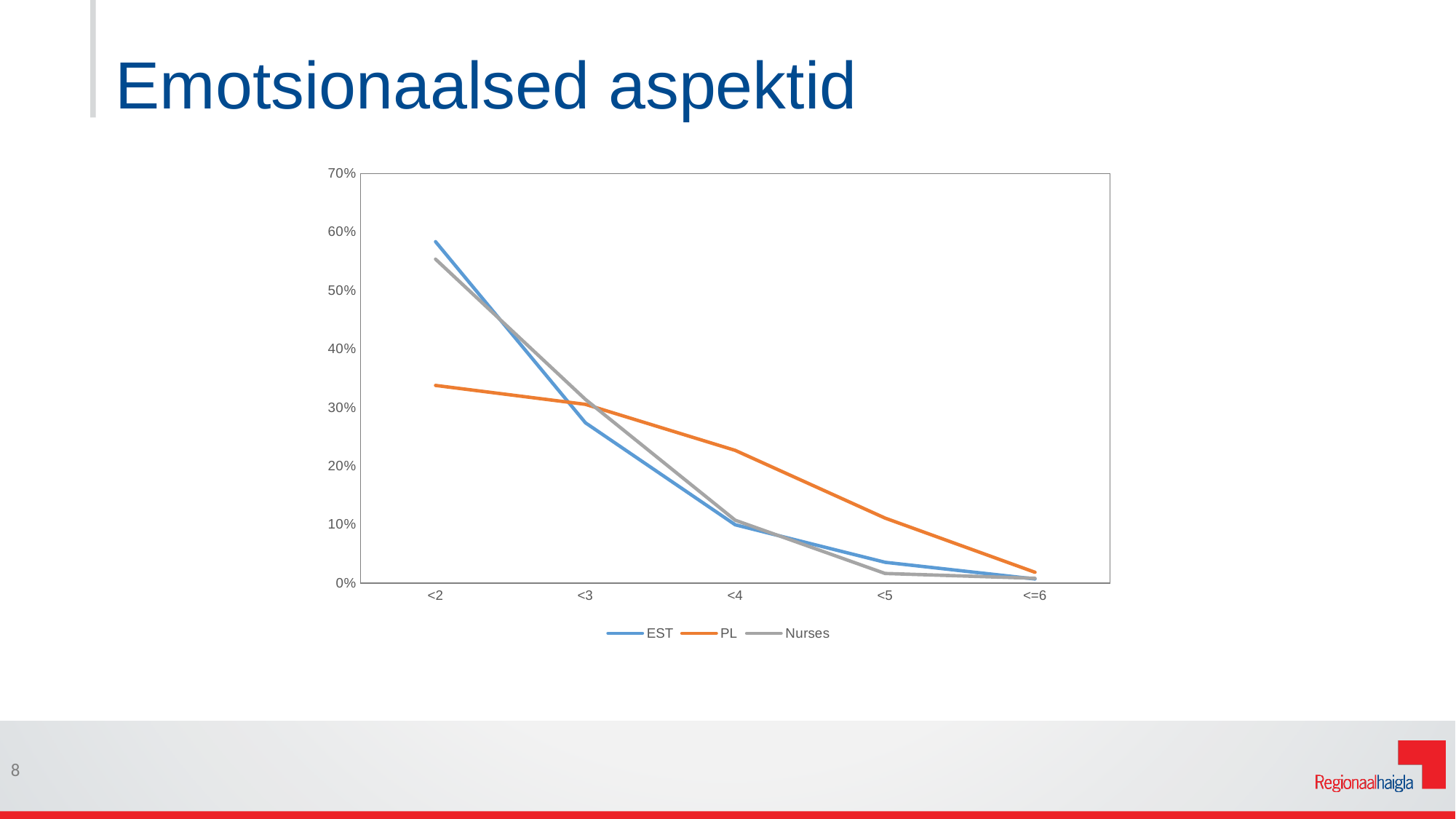
Do the values for EST rise or fall from <2 to <=6? fall What kind of chart is shown on the slide? line chart Which series are listed in the legend? EST, PL, Nurses Is the value for EST at <2 greater or less than 50%? greater Which series has the highest value at <2? EST How many series does the legend list? 3 How many categories are shown on the x axis? 5 At <4, is the value for PL or EST larger? PL Which series has the highest value at <5? PL Do the values for PL rise or fall along the x axis? fall Is the value for PL at <4 greater or less than 20%? greater Is the value for PL at <2 greater or less than 40%? less